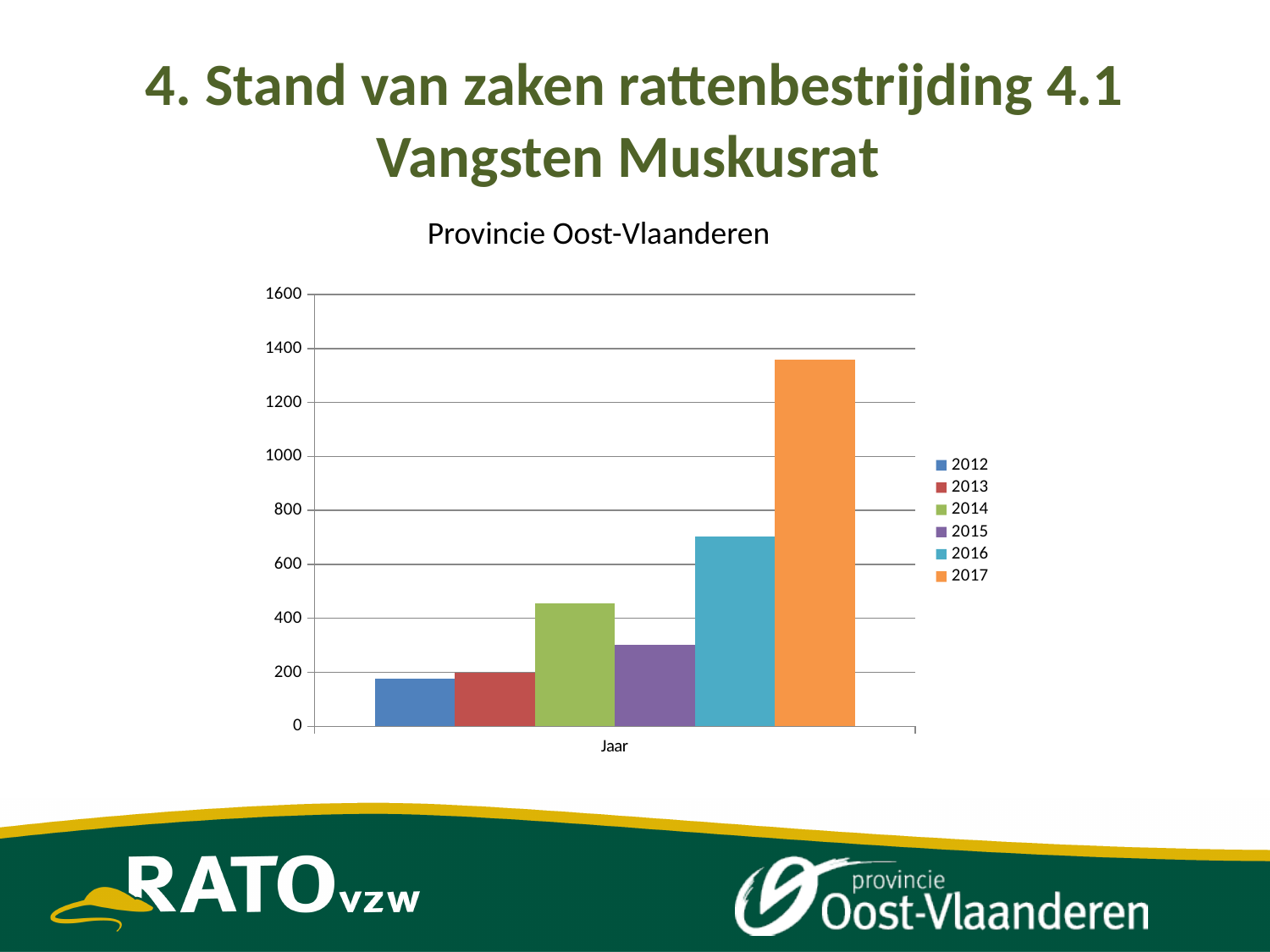
What is the label of the horizontal axis? Jaar Is the value for 2017 greater or less than 1200? greater Is the value for 2014 greater or less than 400? greater What type of chart is shown on the slide? bar chart How many series does the legend list? 6 Which year has the lowest value? 2012 Is the value for 2016 greater or less than 800? less How many bars are plotted in the chart? 6 Which is larger, the value for 2014 or the value for 2015? 2014 Which year has the highest value? 2017 Which is larger, the value for 2016 or the value for 2014? 2016 What is the title of the chart? Provincie Oost-Vlaanderen